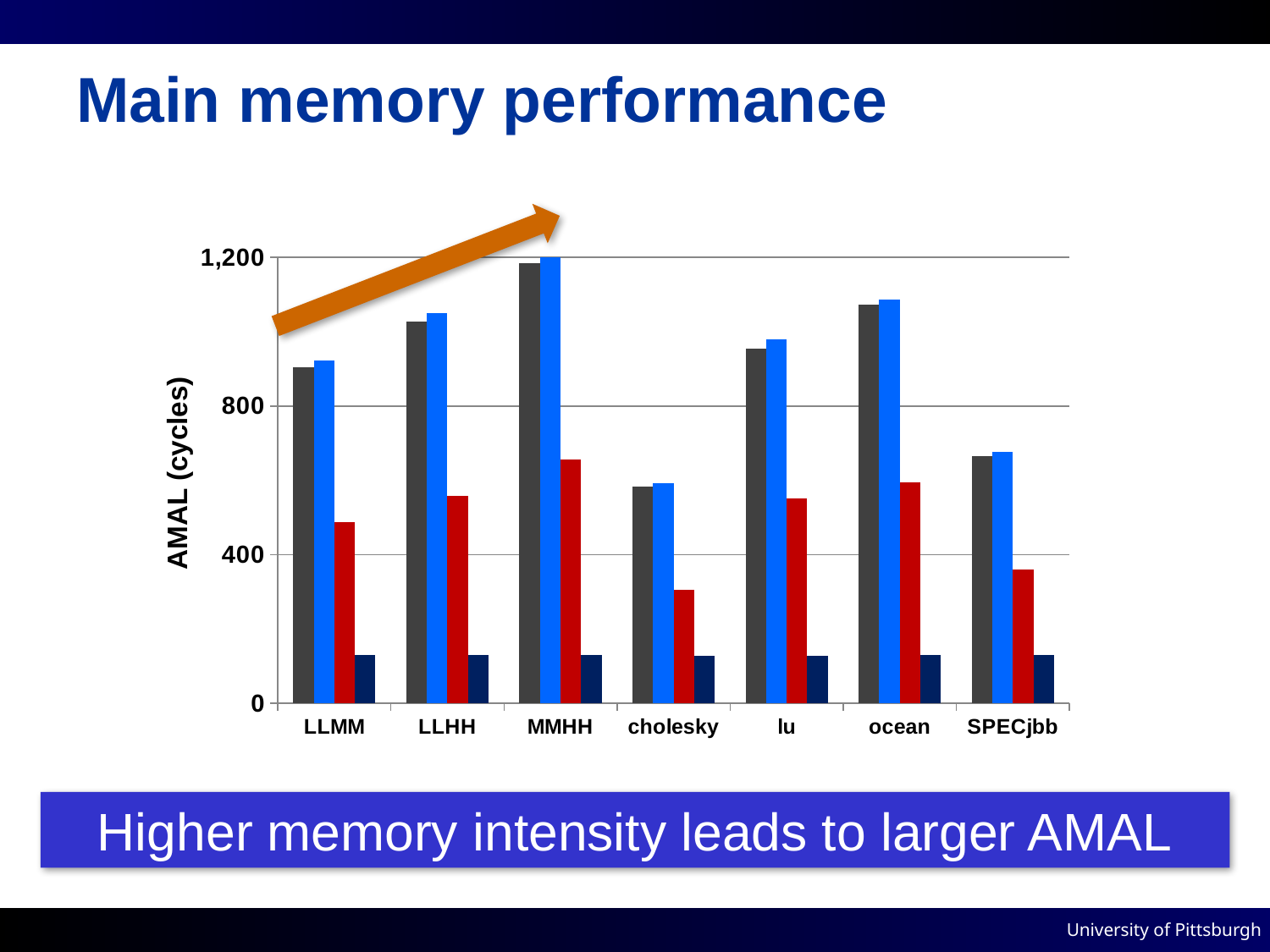
Which category has the shortest dark gray bar? cholesky Is the red bar for MMHH greater or less than 800? less Is the dark gray bar for LLMM greater or less than 800? greater Which category has the tallest blue bar? MMHH Is the blue bar for ocean greater or less than 800? greater What kind of chart is shown on the slide? bar chart How many categories are shown on the x axis of the chart? 7 Do the blue bars rise or fall from LLMM to MMHH? rise Which is larger, the blue bar for ocean or the blue bar for lu? ocean What is the label of the y axis of the chart? AMAL (cycles) What is the title of the slide containing the chart? Main memory performance